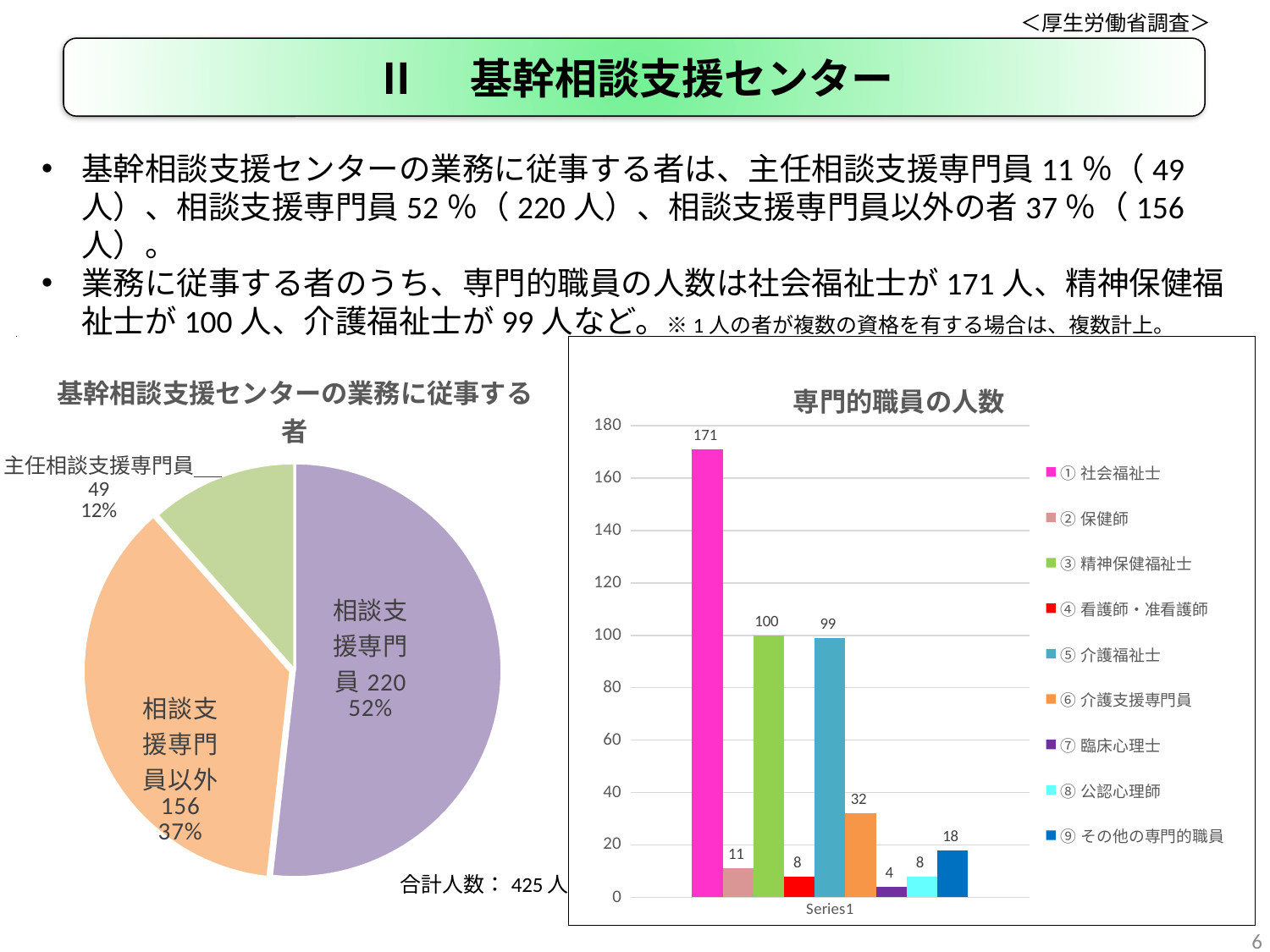
In the bar chart titled 専門的職員の人数, which category has the highest value? ① 社会福祉士 In the pie chart titled 基幹相談支援センターの業務に従事する者, how many slices are there? 3 In the pie chart titled 基幹相談支援センターの業務に従事する者, which slice is the smallest? 主任相談支援専門員 In the bar chart titled 専門的職員の人数, what is the value for ⑥ 介護支援専門員? 32 In the bar chart titled 専門的職員の人数, which category has the lowest value? ⑦ 臨床心理士 In the pie chart titled 基幹相談支援センターの業務に従事する者, what is the value for 相談支援専門員以外? 156 In the pie chart titled 基幹相談支援センターの業務に従事する者, what share of the pie is 相談支援専門員? 52% In the bar chart titled 専門的職員の人数, which is larger: the value for ② 保健師 or the value for ⑨ その他の専門的職員? ⑨ その他の専門的職員 In the bar chart titled 専門的職員の人数, what is the value for ① 社会福祉士? 171 What kind of chart is the chart titled 専門的職員の人数? bar chart In the bar chart titled 専門的職員の人数, what is the difference between the values for ③ 精神保健福祉士 and ⑤ 介護福祉士? 1 In the bar chart titled 専門的職員の人数, how many series does the legend list? 9